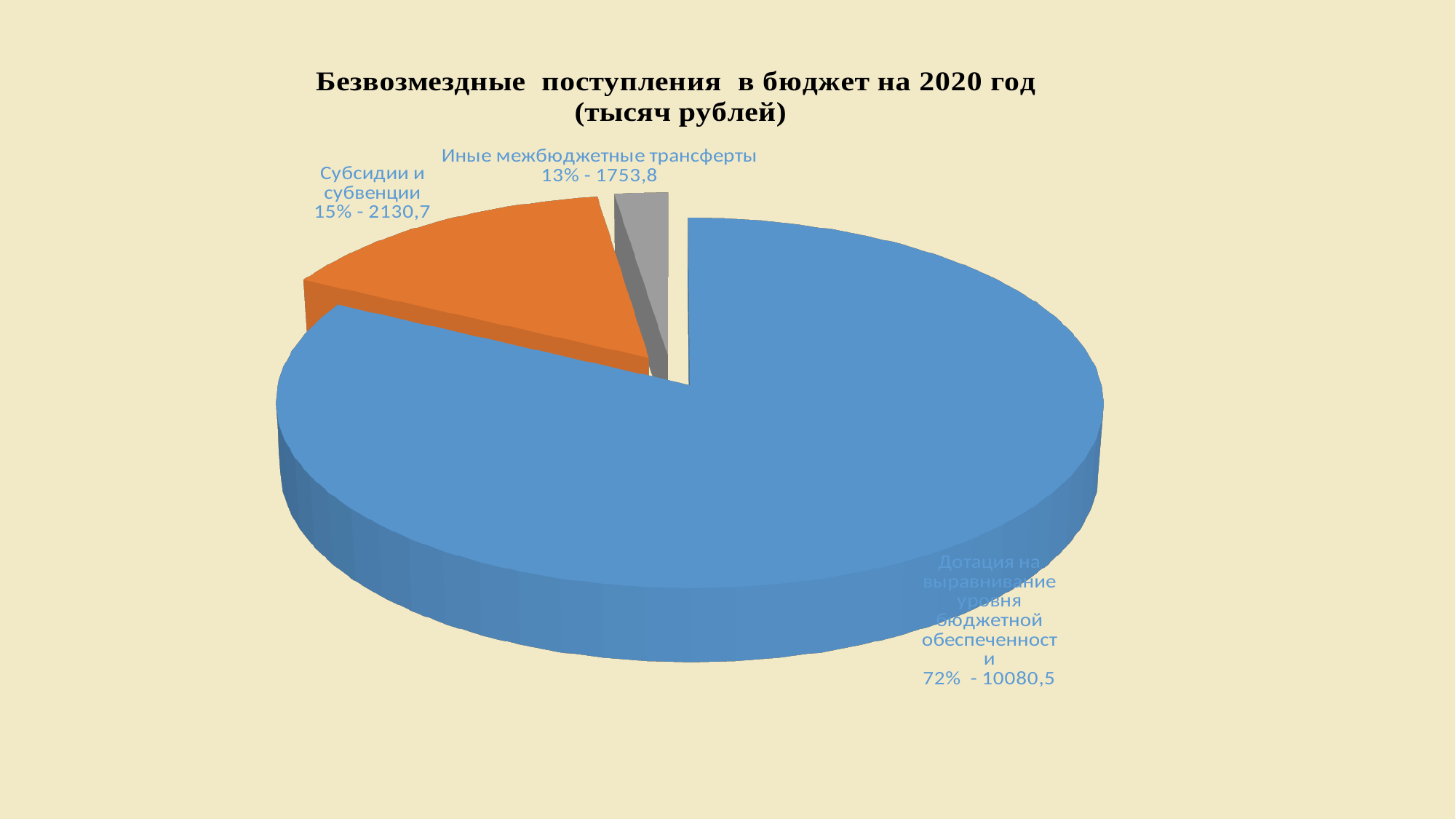
What is the title of the chart? Безвозмездные поступления в бюджет на 2020 год (тысяч рублей) What share of the pie does Дотация на выравнивание уровня бюджетной обеспеченности represent? 72% What is the value for Субсидии и субвенции? 2130,7 What is the value for Иные межбюджетные трансферты? 1753,8 What share of the pie does Иные межбюджетные трансферты represent? 13% How many slices does the pie chart have? 3 Which category has the largest slice? Дотация на выравнивание уровня бюджетной обеспеченности What is the value for Дотация на выравнивание уровня бюджетной обеспеченности? 10080,5 Which category has the smallest slice? Иные межбюджетные трансферты What kind of chart is shown on the slide? Pie chart What is the difference between the values for Субсидии и субвенции and Иные межбюджетные трансферты? 376,9 Which is larger, Субсидии и субвенции or Иные межбюджетные трансферты? Субсидии и субвенции